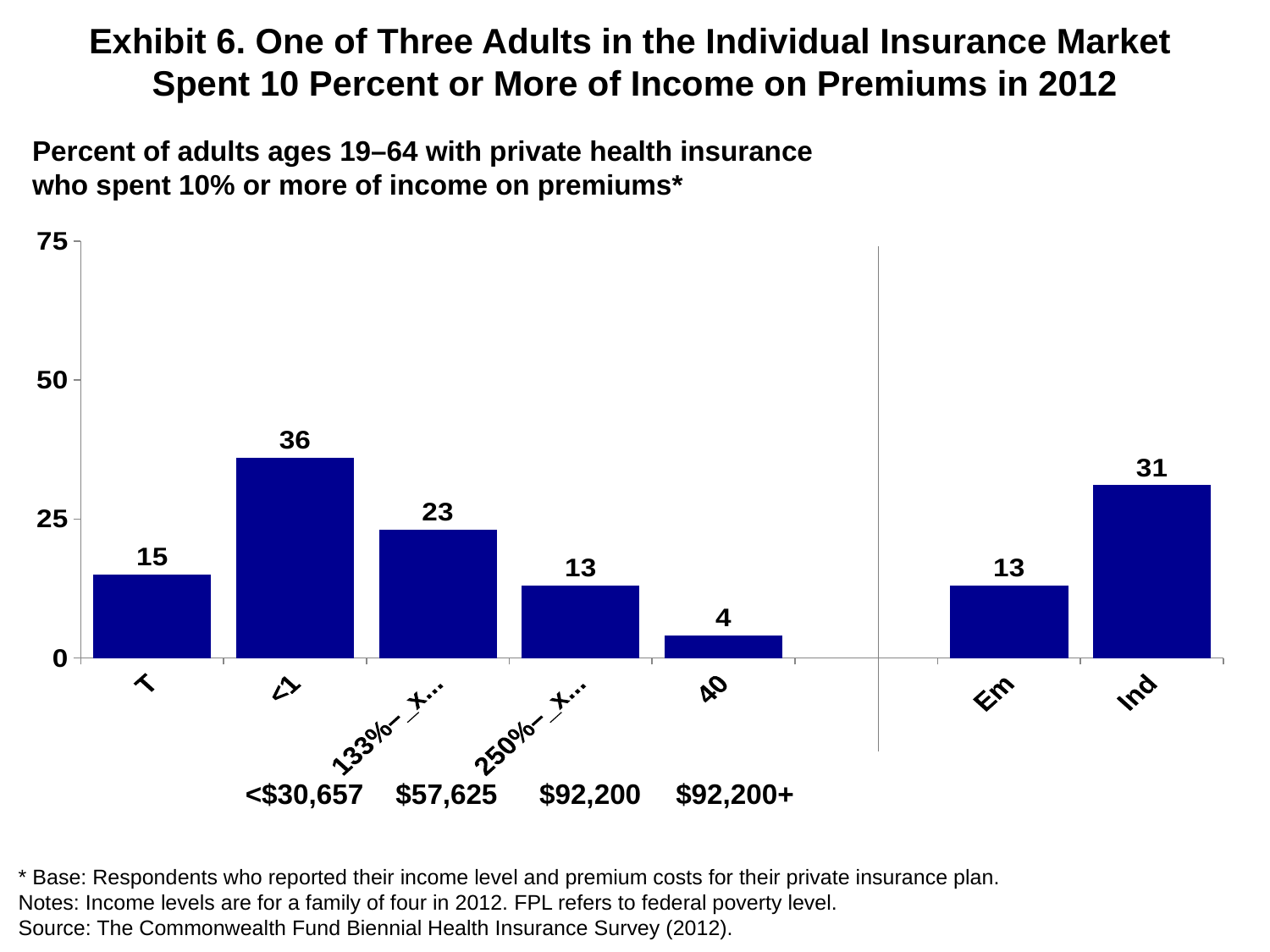
What is the value of the bar labeled "Ind"? 31 Which is larger, the value for "Ind" or the value for "Em"? Ind How many bars are plotted in the chart? 7 Is the value of the bar labeled "<1" greater or less than 25? greater Which bar has the lowest value in the chart? the bar labeled "40" (4) What is the value of the first bar, labeled "T"? 15 What is the value of the bar labeled "Em"? 13 Which bar has the highest value in the chart? the bar labeled "<1" (36) What is the difference between the value of the bar labeled "<1" (36) and the third bar (23)? 13 What kind of chart is shown on the slide? bar chart What is the exhibit number given in the slide title? Exhibit 6 What is the difference between the values of the bars labeled "Ind" and "Em"? 18